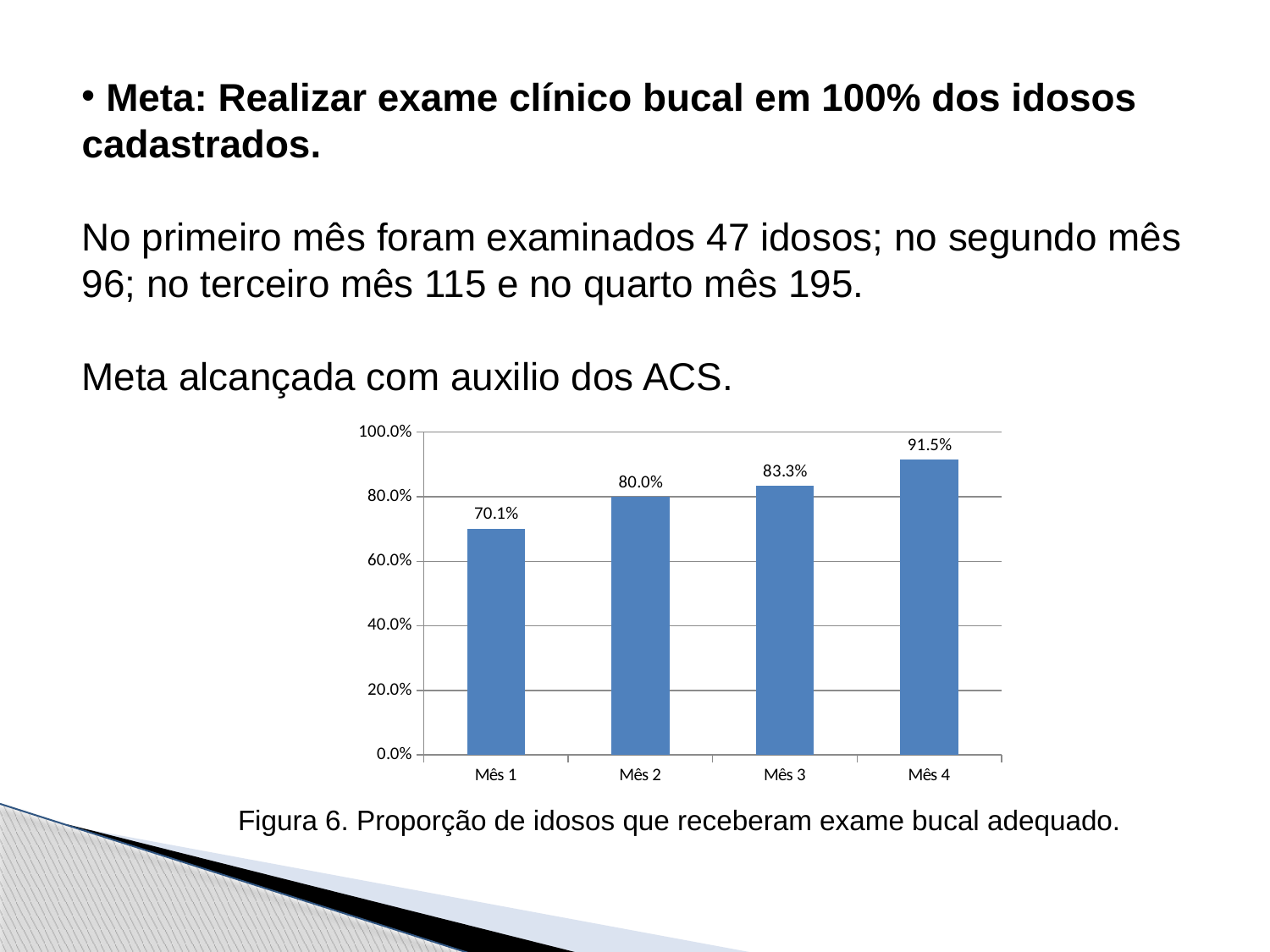
What is the value for Mês 1? 70.1% Which month has the highest value? Mês 4 Which is larger, the value for Mês 2 or the value for Mês 3? Mês 3 What is the value for Mês 2? 80.0% How many months are shown on the x axis? 4 What kind of chart is shown on the slide? bar chart What is the value for Mês 3? 83.3% What is the value for Mês 4? 91.5% Is the value for Mês 1 greater or less than 80.0%? less Do the values rise or fall from Mês 1 to Mês 4? rise Which month has the lowest value? Mês 1 What is the difference between the values for Mês 4 and Mês 1? 21.4%